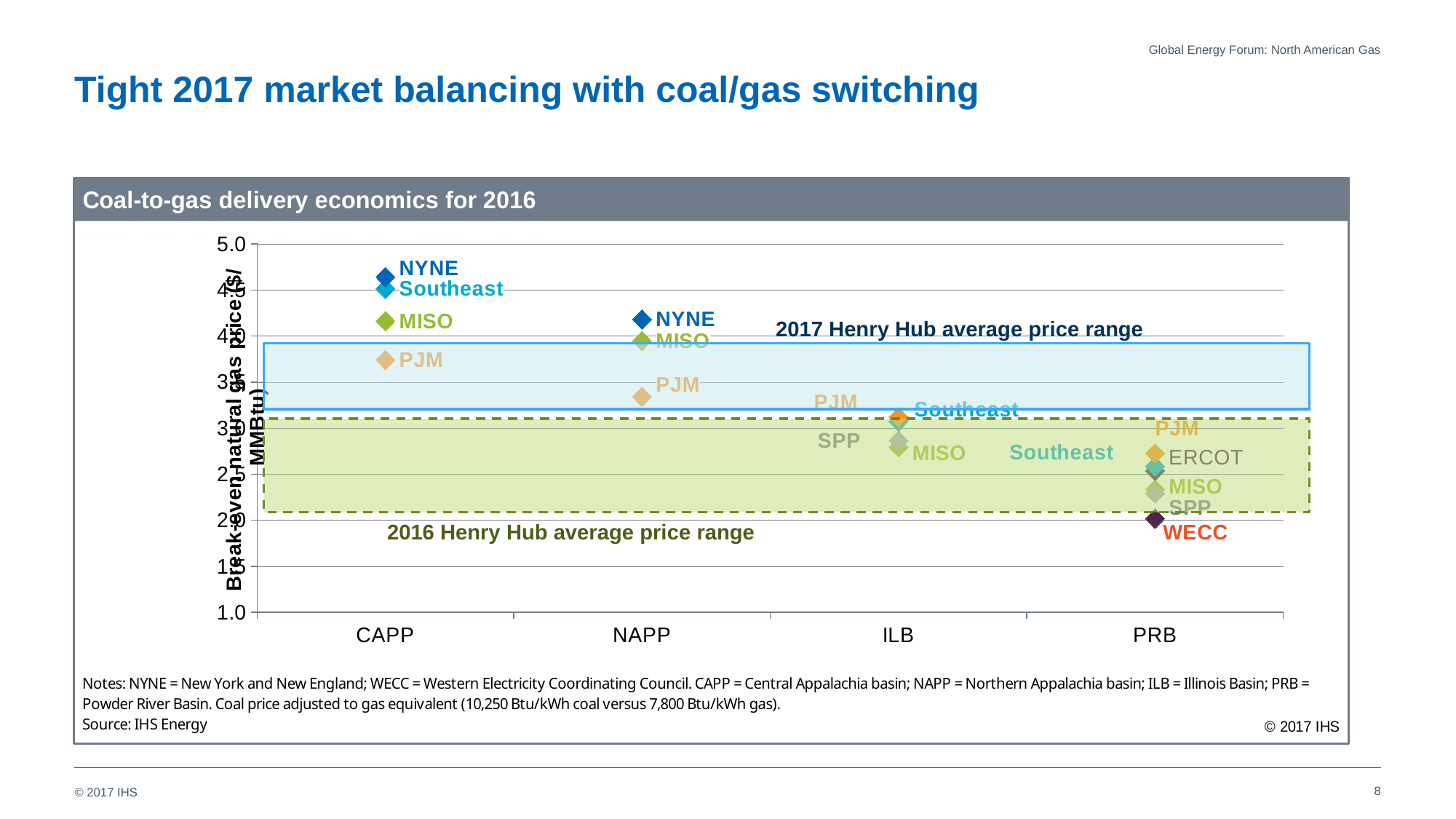
Is the break-even price for MISO at ILB greater or less than 3.0? less Is the break-even price for NYNE at NAPP greater or less than 3.5? greater Which basin has the highest break-even natural gas price point on the chart? CAPP Is the break-even price for PJM at CAPP greater or less than 4.0? less Do the break-even natural gas prices generally rise or fall moving from CAPP to PRB along the x axis? fall Which market has the lowest break-even natural gas price on the chart? WECC How many coal basins are shown along the x axis? 4 Which is higher, the break-even price for NYNE at CAPP or NYNE at NAPP? NYNE at CAPP What is the title of the chart? Coal-to-gas delivery economics for 2016 What kind of chart is shown on the slide? scatter chart